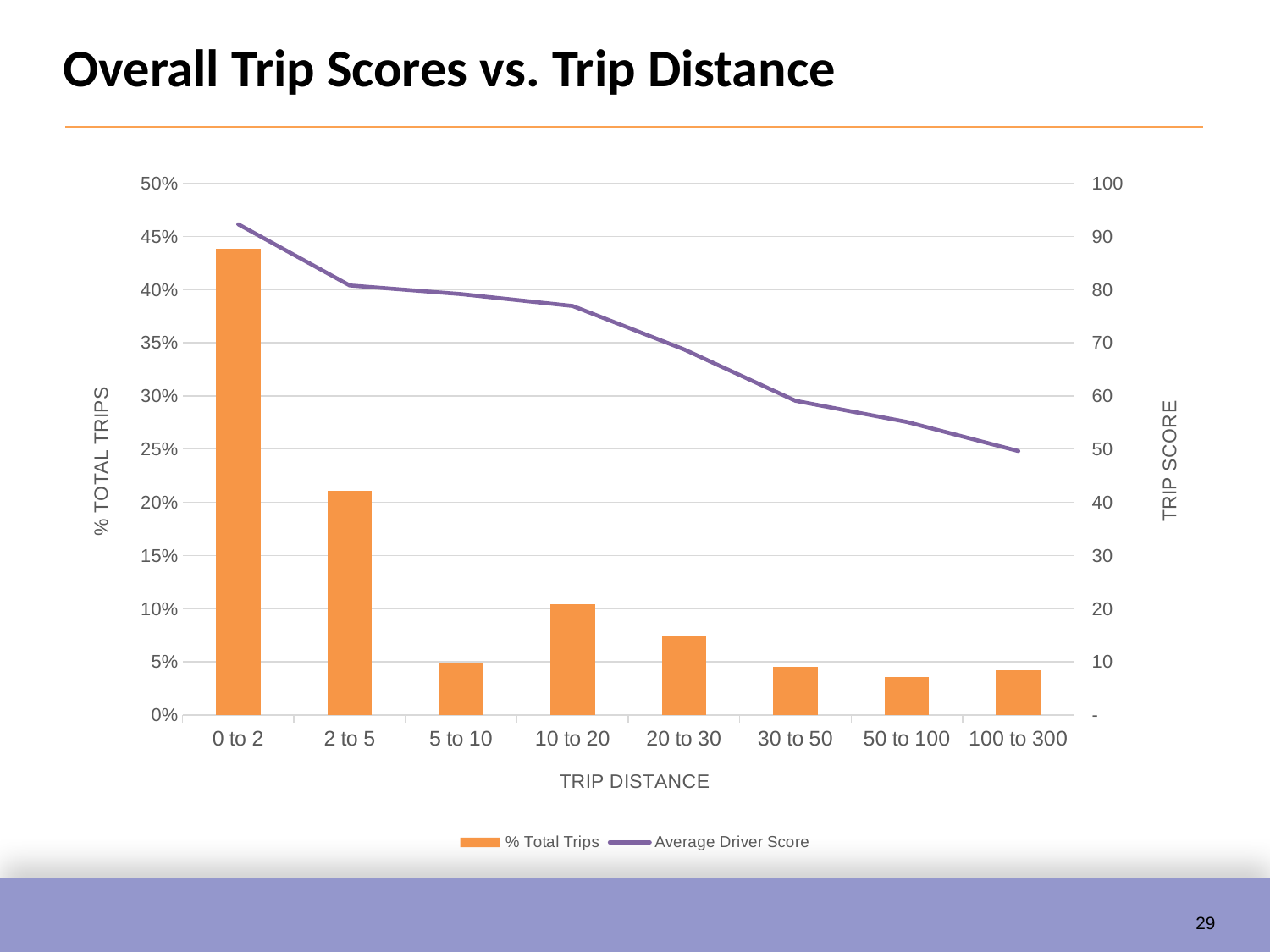
Which trip distance category has the highest Average Driver Score? 0 to 2 How many trip distance categories are shown on the x axis? 8 Is the % Total Trips for the 5 to 10 category greater or less than 10%? less What kind of chart is shown on the slide? A combined bar and line chart What is the title of the chart on the slide? Overall Trip Scores vs. Trip Distance Is the % Total Trips for the 0 to 2 category greater or less than 40%? greater How many series does the legend list? 2 Which trip distance category has the lowest Average Driver Score? 100 to 300 Which has a higher % Total Trips, the 10 to 20 category or the 20 to 30 category? 10 to 20 Is the Average Driver Score for the 100 to 300 category greater or less than 60? less Which trip distance category has the highest % Total Trips? 0 to 2 Does the Average Driver Score rise or fall as trip distance increases along the x axis? It falls